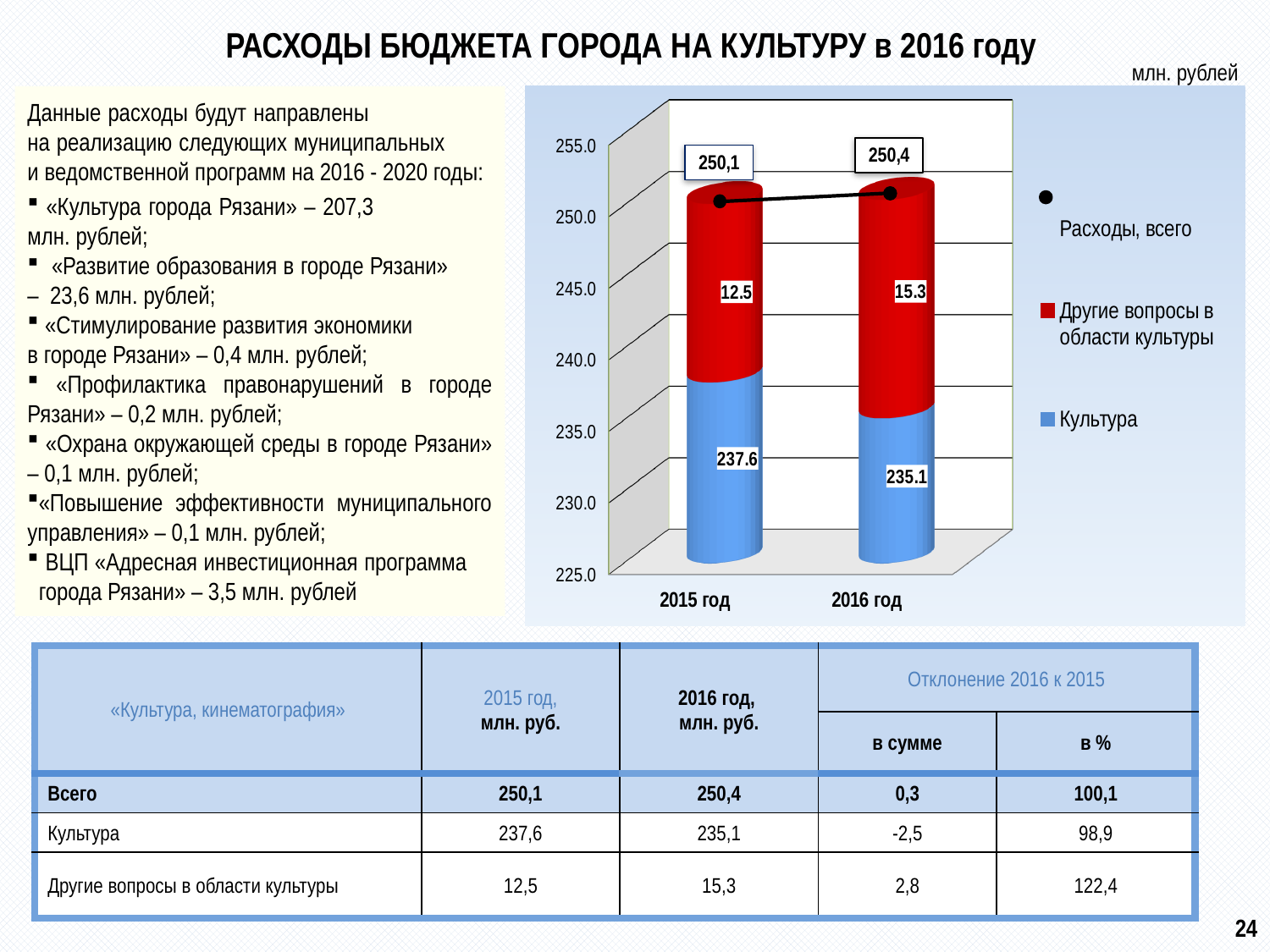
How many series does the chart legend list? 3 What is the difference between the Другие вопросы в области культуры values for 2016 год and 2015 год? 2.8 How many categories are shown on the x axis of the chart? 2 What is the value of the Культура series for 2016 год? 235.1 Which year has the lower value for the Культура series? 2016 год Which year has the higher value for Другие вопросы в области культуры? 2016 год What is the value of Другие вопросы в области культуры for 2016 год? 15.3 What is the value of Расходы, всего for 2015 год? 250,1 Does the Культура series rise or fall from 2015 год to 2016 год? fall What is the difference between the Культура values for 2015 год and 2016 год? 2.5 What is the value of the Культура series for 2015 год? 237.6 What type of chart is shown on the slide? stacked bar chart